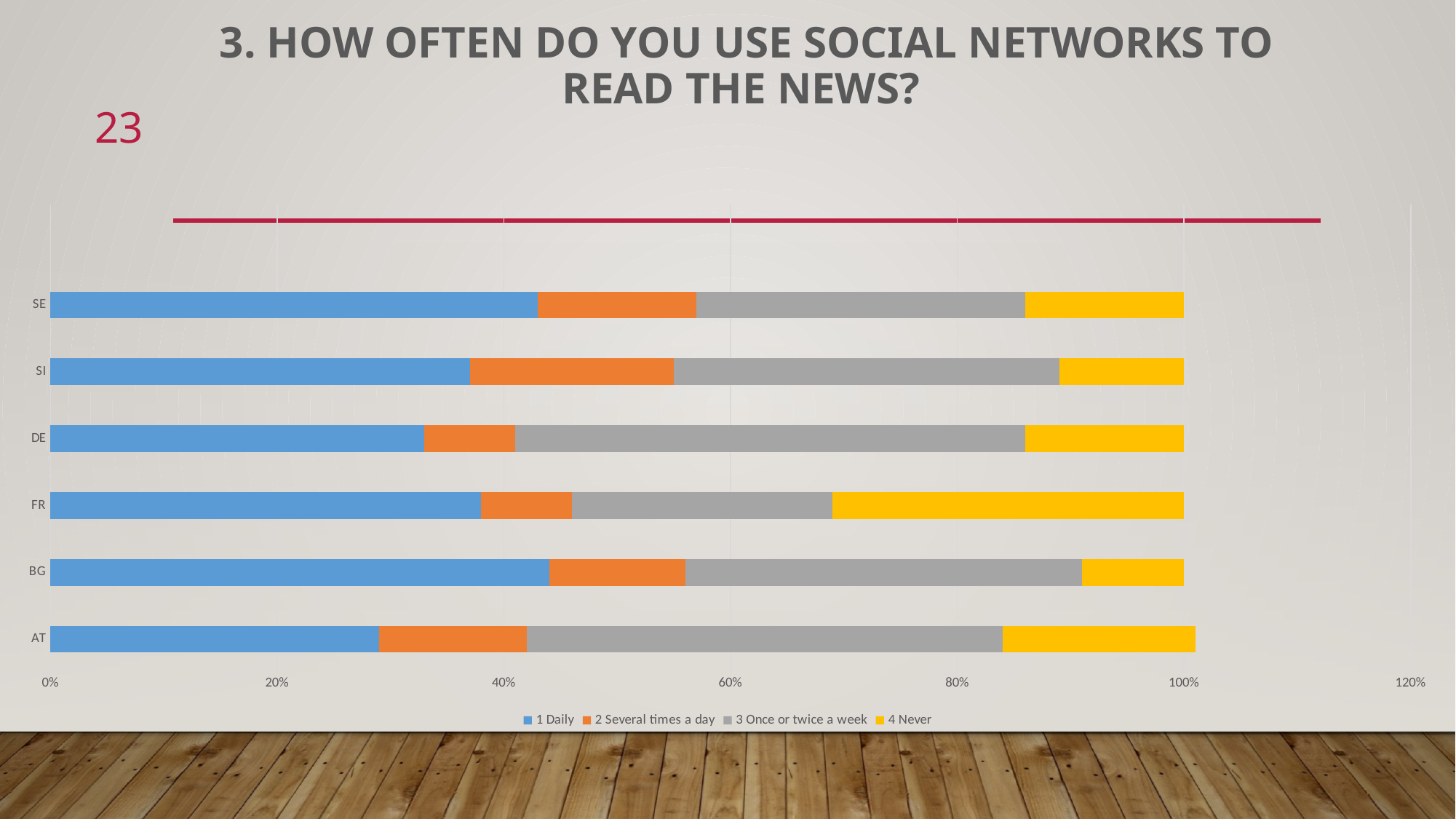
How many countries are listed on the vertical axis of the chart? 6 Which country has the largest '4 Never' share in the chart? FR Is the '1 Daily' value for DE greater or less than 40%? less What is the title of the chart on the slide? 3. How often do you use social networks to read the news? Which colour represents the '4 Never' series in the chart? Yellow What kind of chart is shown on the slide? Stacked bar chart Is the '1 Daily' value for AT greater or less than 40%? less Which is larger, the '1 Daily' share for SE or for AT? SE Which is larger, the '2 Several times a day' share for SI or for FR? SI Is the '1 Daily' value for BG greater or less than 40%? greater Which country has the smallest '1 Daily' share in the chart? AT How many series does the chart legend list? 4